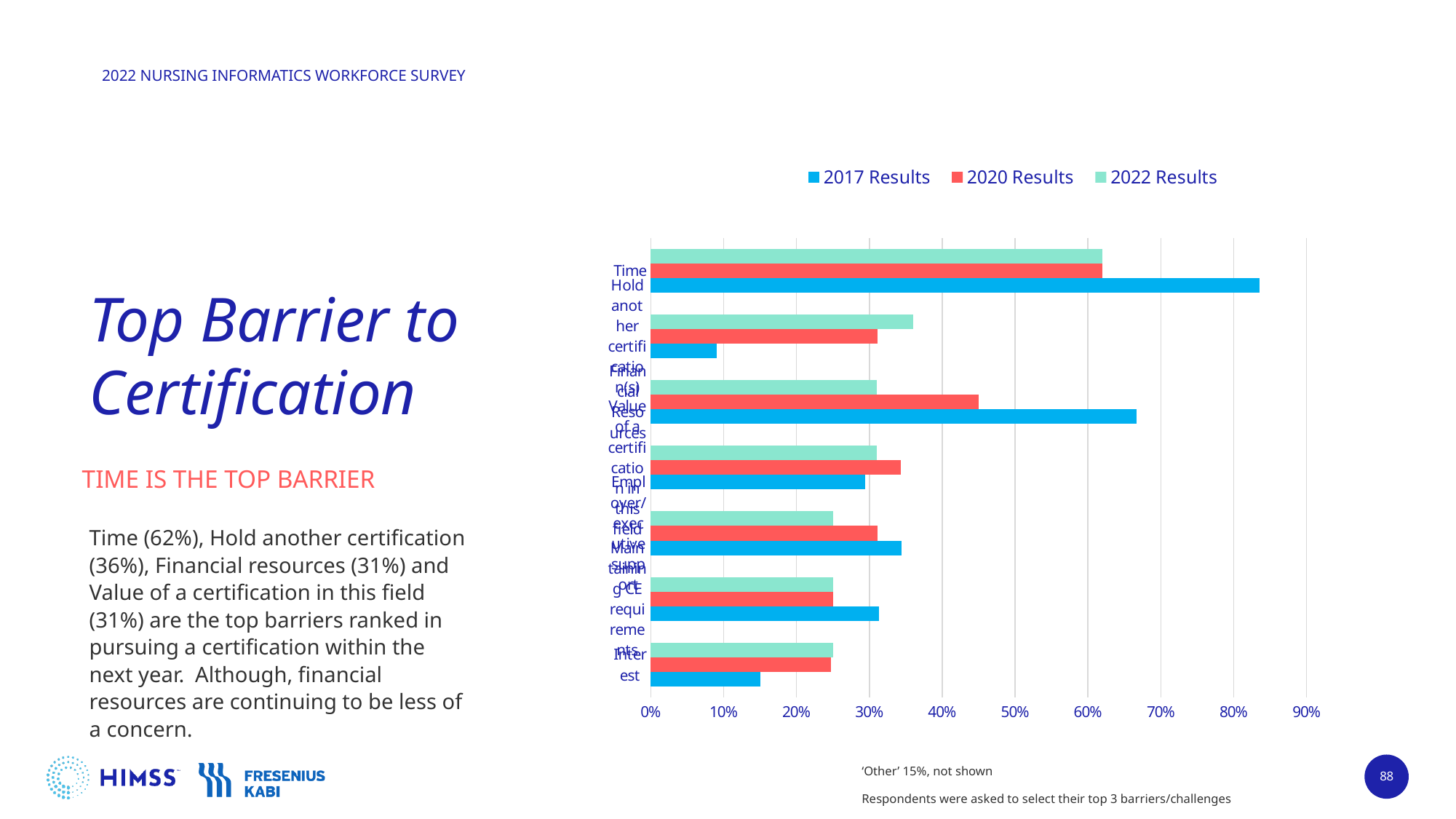
Which barrier has the lowest value in the 2017 Results series? Hold another certification(s) Which barrier has the highest value in the 2022 Results series? Time Is the 2017 Results value for Financial Resources greater or less than 60%? greater How many barrier categories are plotted in the chart? 7 Is the 2017 Results value for Time greater or less than 80%? greater Does the value for Financial Resources rise or fall from 2017 Results to 2022 Results? fall What kind of chart is shown on the slide? bar chart How many series does the legend list? 3 Is the 2020 Results value for Financial Resources greater or less than 50%? less Which series are listed in the chart legend? 2017 Results, 2020 Results, 2022 Results For Time, which is larger: the 2017 Results value or the 2022 Results value? 2017 Results